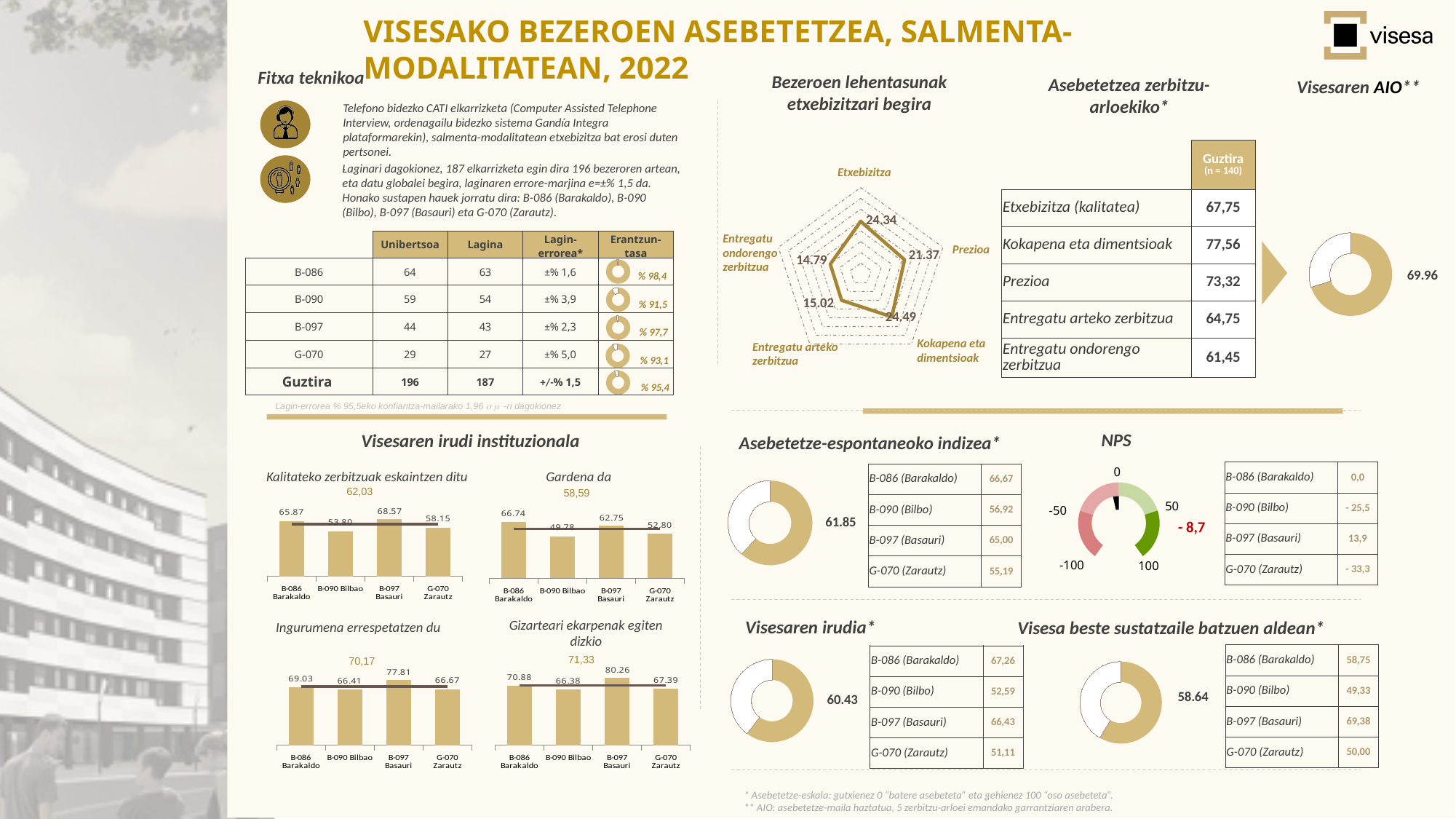
What value is shown on the NPS gauge chart? - 8,7 In the 'Kalitateko zerbitzuak eskaintzen ditu' bar chart, what is the value for B-097 Basauri? 68.57 In the radar chart 'Bezeroen lehentasunak etxebizitzari begira', which category has the lowest value? Entregatu ondorengo zerbitzua What value is shown next to the 'Visesaren AIO' donut chart? 69.96 In the radar chart 'Bezeroen lehentasunak etxebizitzari begira', what is the value for Kokapena eta dimentsioak? 24.49 In the 'Gardena da' bar chart, what is the value for B-086 Barakaldo? 66.74 In the 'Kalitateko zerbitzuak eskaintzen ditu' bar chart, which category has the lowest value? B-090 Bilbao In the 'Gizarteari ekarpenak egiten dizkio' bar chart, which is larger, the value for B-097 Basauri or B-090 Bilbao? B-097 Basauri In the 'Gizarteari ekarpenak egiten dizkio' bar chart, what is the value for G-070 Zarautz? 67.39 In the 'Ingurumena errespetatzen du' bar chart, which category has the highest value? B-097 Basauri In the 'Gardena da' bar chart, what is the difference between the values for B-086 Barakaldo and B-090 Bilbao? 16.96 How many categories are shown in the 'Ingurumena errespetatzen du' bar chart? 4